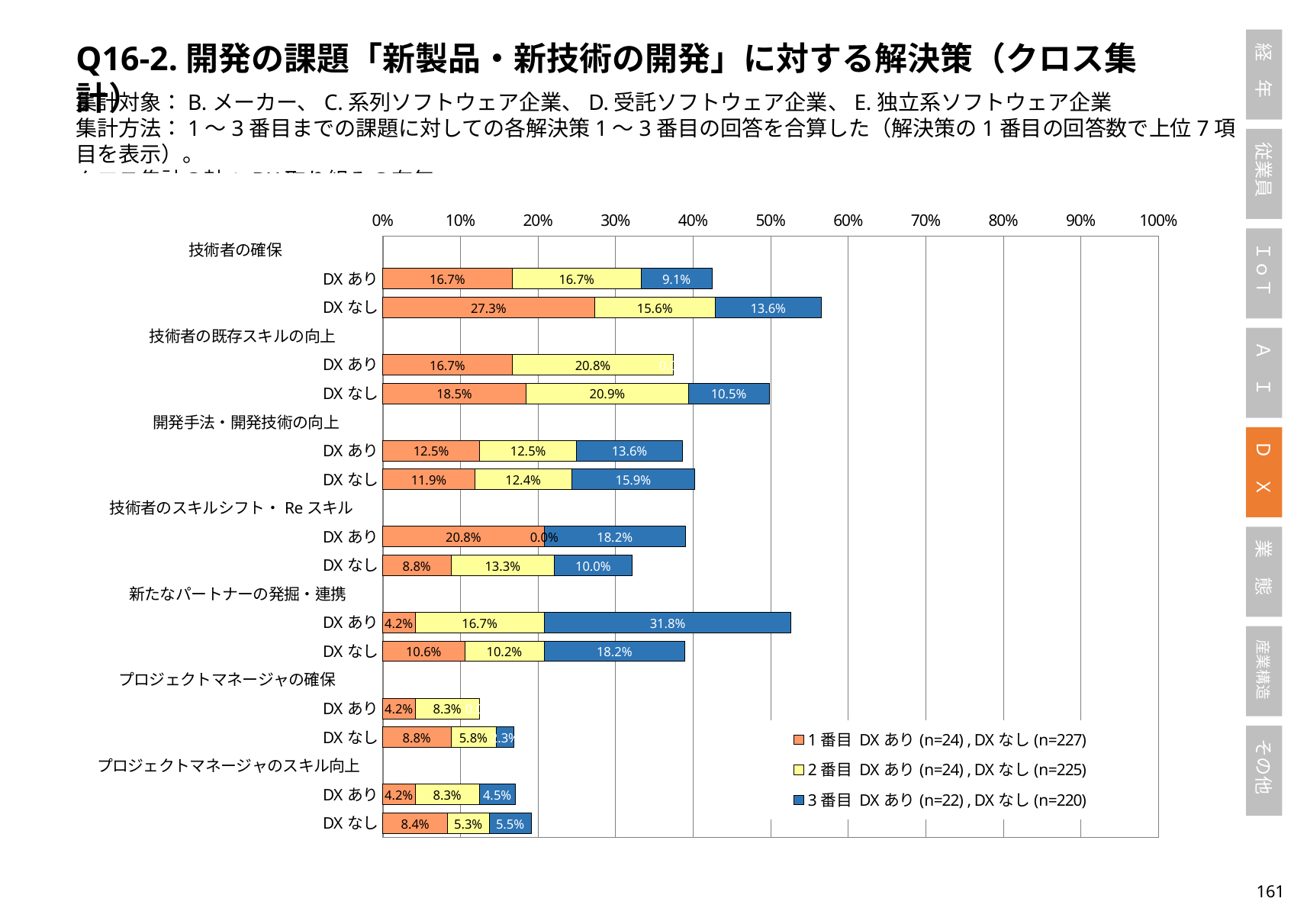
What is the 2番目 value for 技術者のスキルシフト・Re スキル DX あり? 0.0% What is the total of the stacked bar for 開発手法・開発技術の向上 DX なし? 40.2% How many solution categories (excluding the DX あり/DX なし rows) are shown on the chart? 7 Is the total stacked bar for 技術者の確保 DX なし greater or less than 50%? greater What is the 1番目 value for 技術者の確保 DX なし? 27.3% How many series does the legend list? 3 What is the total of the stacked bar for 新たなパートナーの発掘・連携 DX あり? 52.7% What is the difference between the 1番目 values for 技術者の確保 DX なし and DX あり? 10.6% Which row has the highest 1番目 value? 技術者の確保 DX なし Which is larger: the 3番目 value for 開発手法・開発技術の向上 DX なし or DX あり? DX なし What is the 3番目 value for 新たなパートナーの発掘・連携 DX あり? 31.8% What kind of chart is shown on the slide? Stacked bar chart